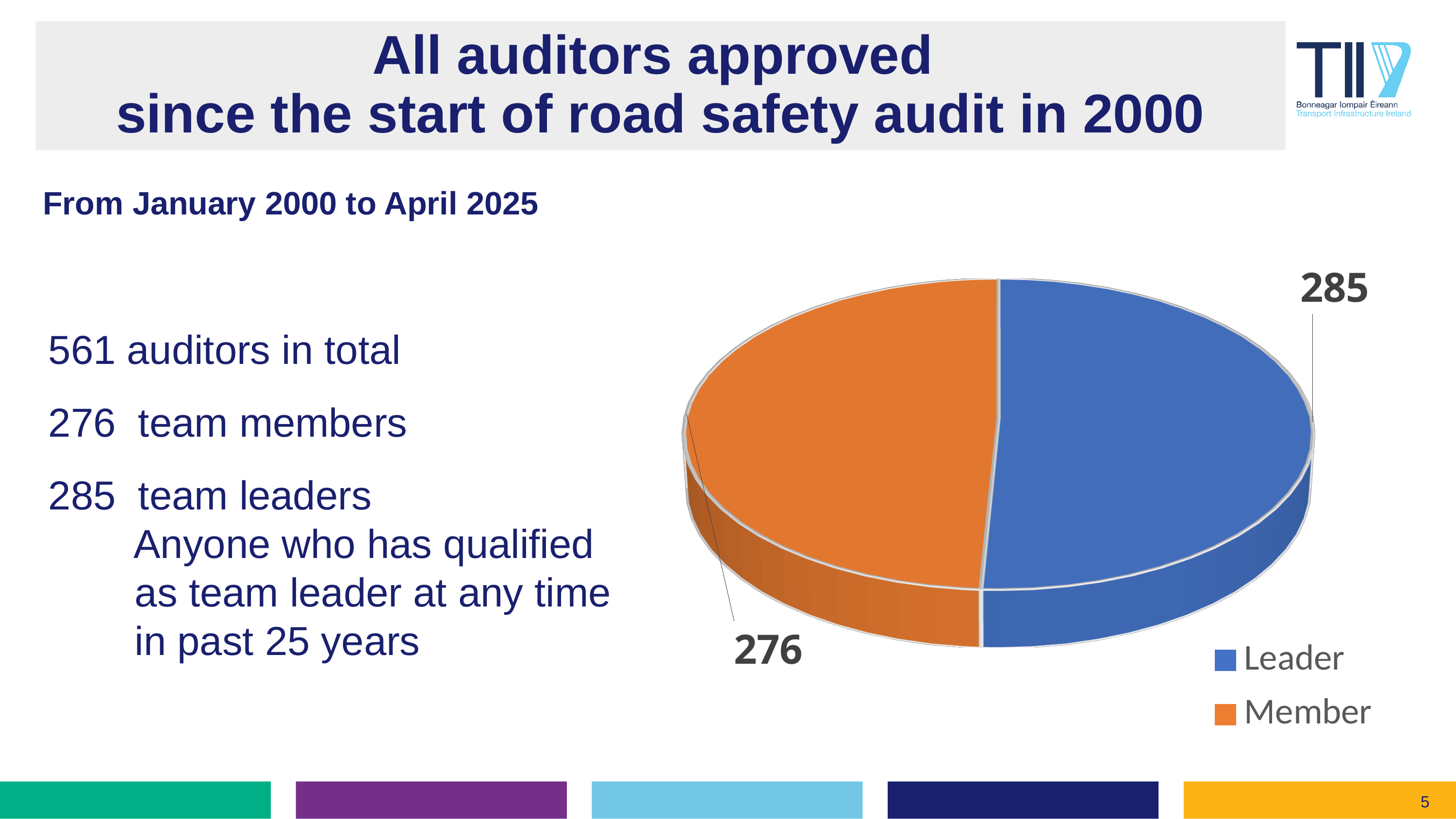
What is the value for Leader in the pie chart? 285 What kind of chart is shown on the slide? pie chart Which slice of the pie chart has the larger value? Leader Which slice of the pie chart has the smaller value? Member What is the difference between the Leader and Member values in the pie chart? 9 Is the value for Leader larger or smaller than the value for Member? larger What is the total of the two slices in the pie chart? 561 How many entries does the legend of the pie chart list? 2 What colour is the Member slice in the pie chart? orange How many slices does the pie chart have? 2 What is the value for Member in the pie chart? 276